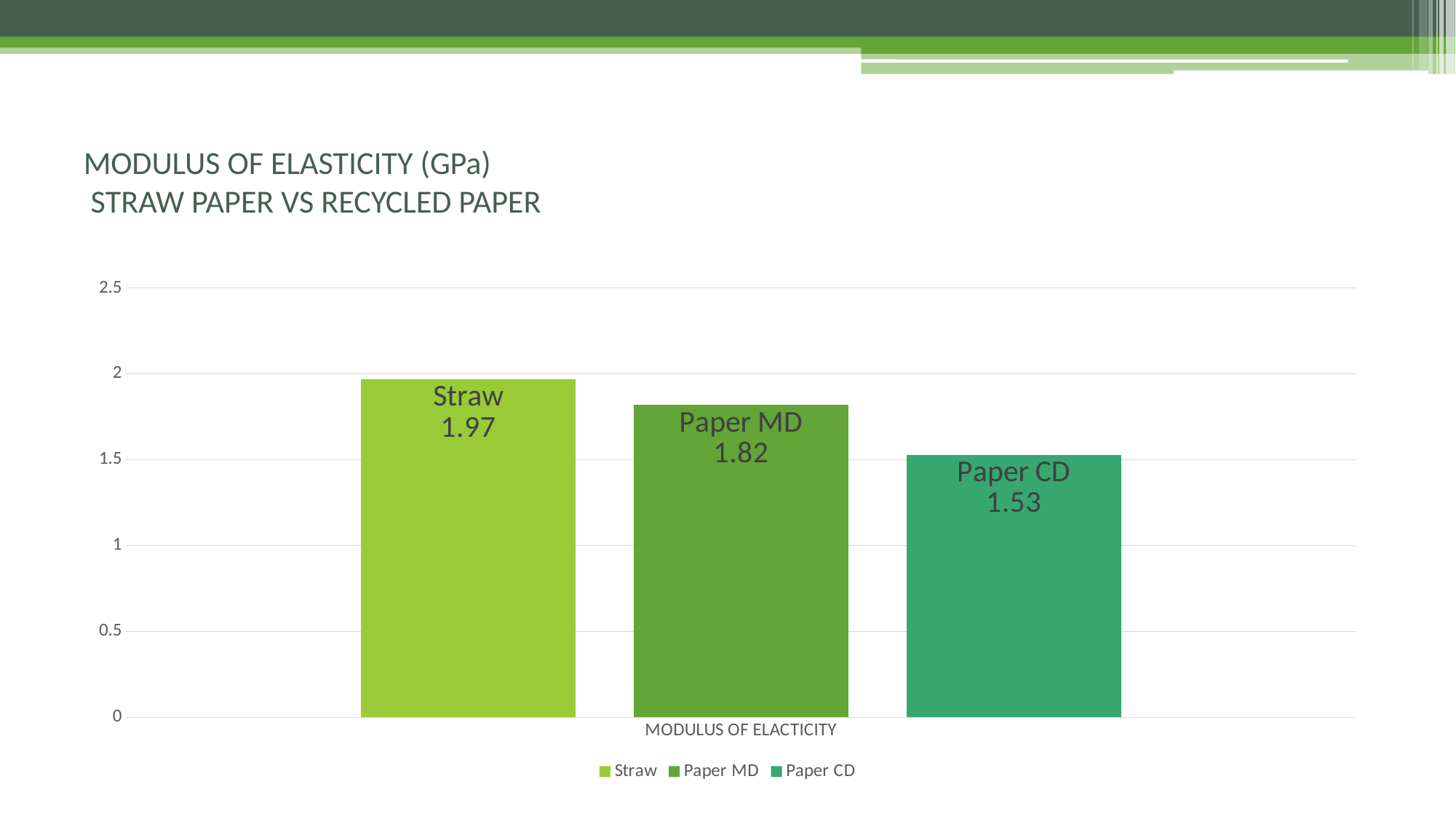
Which series has the highest modulus of elasticity? Straw What is the modulus of elasticity value shown for Paper CD? 1.53 What kind of chart is shown on the slide? bar chart Which is larger, the value for Paper MD or the value for Paper CD? Paper MD What is the modulus of elasticity value shown for Paper MD? 1.82 What is the modulus of elasticity value shown for Straw? 1.97 What is the difference between the Straw value and the Paper MD value? 0.15 Is the value for Straw greater or less than 2? less What is the label shown on the x axis of the chart? MODULUS OF ELACTICITY Which series has the lowest modulus of elasticity? Paper CD What is the difference between the Straw value and the Paper CD value? 0.44 How many series does the legend list? 3